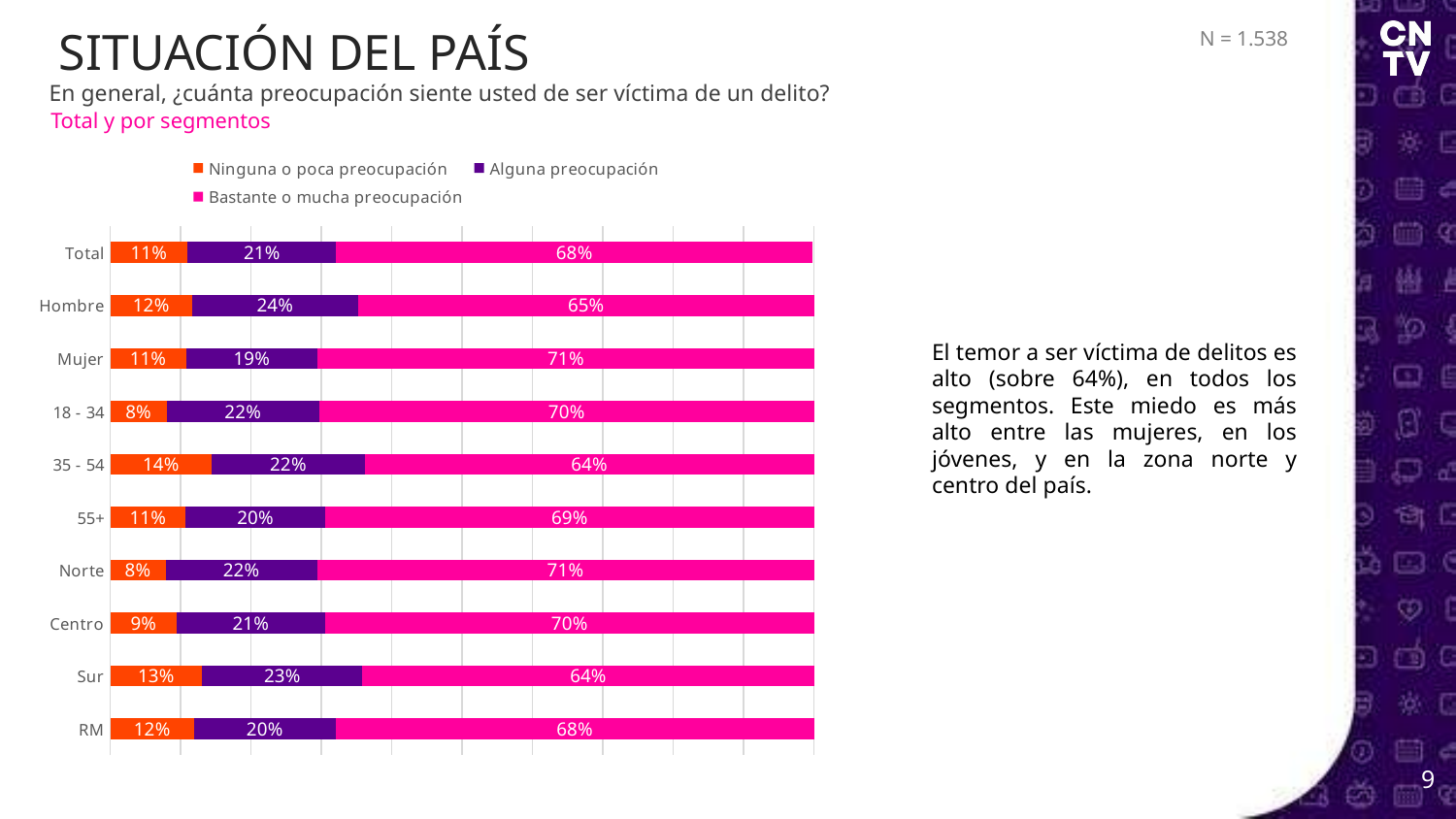
How many series does the legend list? 3 Which category has the highest value for 'Ninguna o poca preocupación'? 35 - 54 What type of chart is shown on the slide? stacked bar chart Which category has the lowest value for 'Alguna preocupación'? Mujer How many categories (segments) are plotted on the chart? 10 What is the value of 'Ninguna o poca preocupación' for 35 - 54? 14% What is the sample size (N) shown on the slide? N = 1.538 What is the value of 'Alguna preocupación' for Hombre? 24% What is the value of 'Bastante o mucha preocupación' for Mujer? 71% Which is larger: the 'Bastante o mucha preocupación' value for Norte or for Sur? Norte What is the difference between the 'Bastante o mucha preocupación' values for Mujer and Hombre? 6% What is the value of 'Bastante o mucha preocupación' for Total? 68%